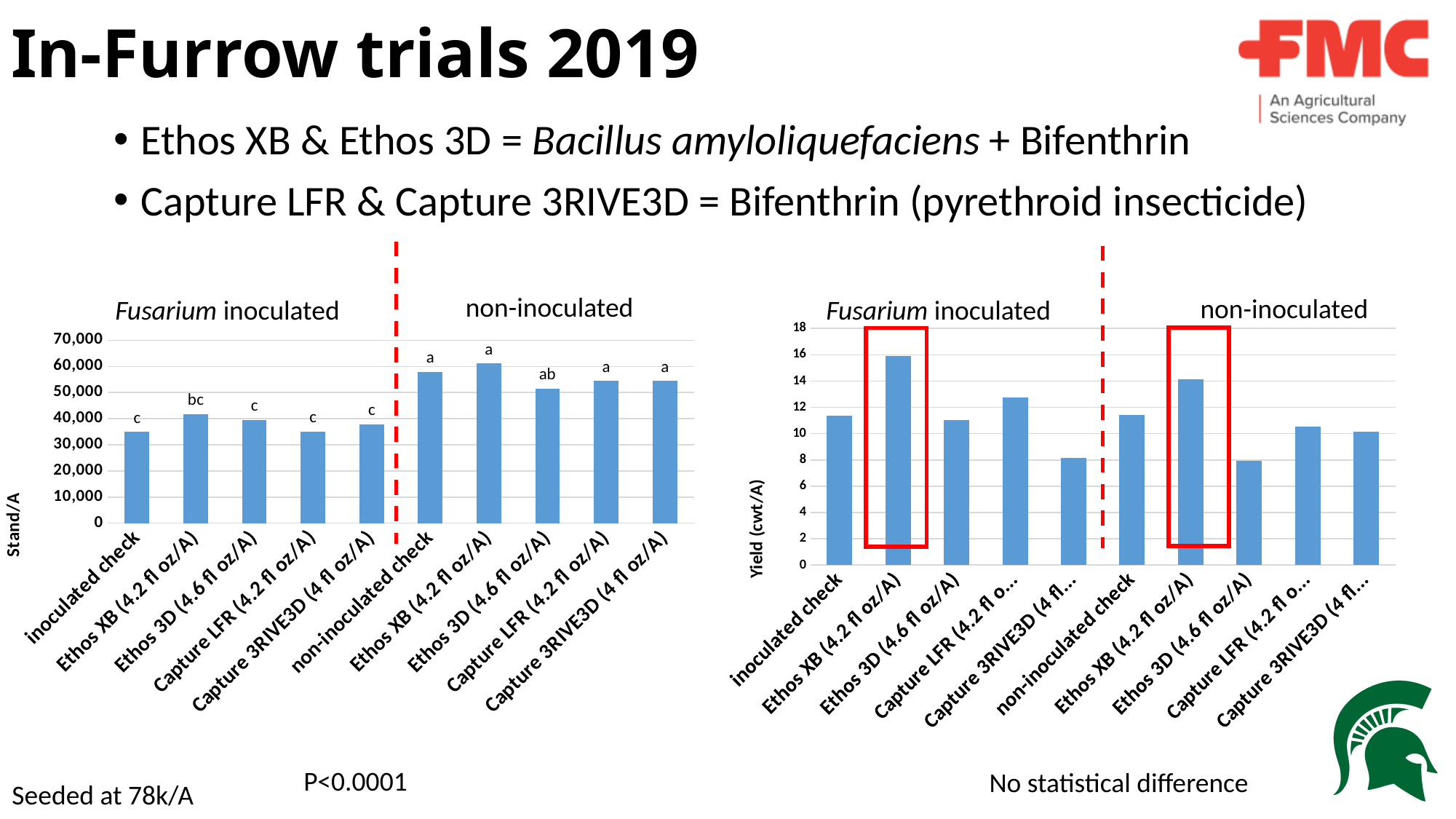
In the right chart (Yield (cwt/A)), which is larger: Capture LFR in the Fusarium inoculated section or Ethos 3D in the non-inoculated section? Capture LFR in the Fusarium inoculated section In the left chart (Stand/A), is the value for the non-inoculated check greater or less than 50,000? greater In the right chart (Yield (cwt/A)), which bar is the highest? Ethos XB (4.2 fl oz/A) in the Fusarium inoculated section In the right chart (Yield (cwt/A)), is the value for Capture 3RIVE3D in the Fusarium inoculated section greater or less than 10? less What kind of chart is the left chart (Stand/A)? bar chart In the left chart (Stand/A), which bar is the highest? Ethos XB (4.2 fl oz/A) in the non-inoculated section In the left chart (Stand/A), which is larger: the non-inoculated check or the inoculated check? non-inoculated check In the left chart (Stand/A), is the value for the inoculated check greater or less than 40,000? less How many bars are plotted in the right chart (Yield (cwt/A))? 10 What is the y-axis label of the right chart? Yield (cwt/A) In the left chart (Stand/A), what statistical grouping letter is printed above the Ethos XB (4.2 fl oz/A) bar in the Fusarium inoculated section? bc